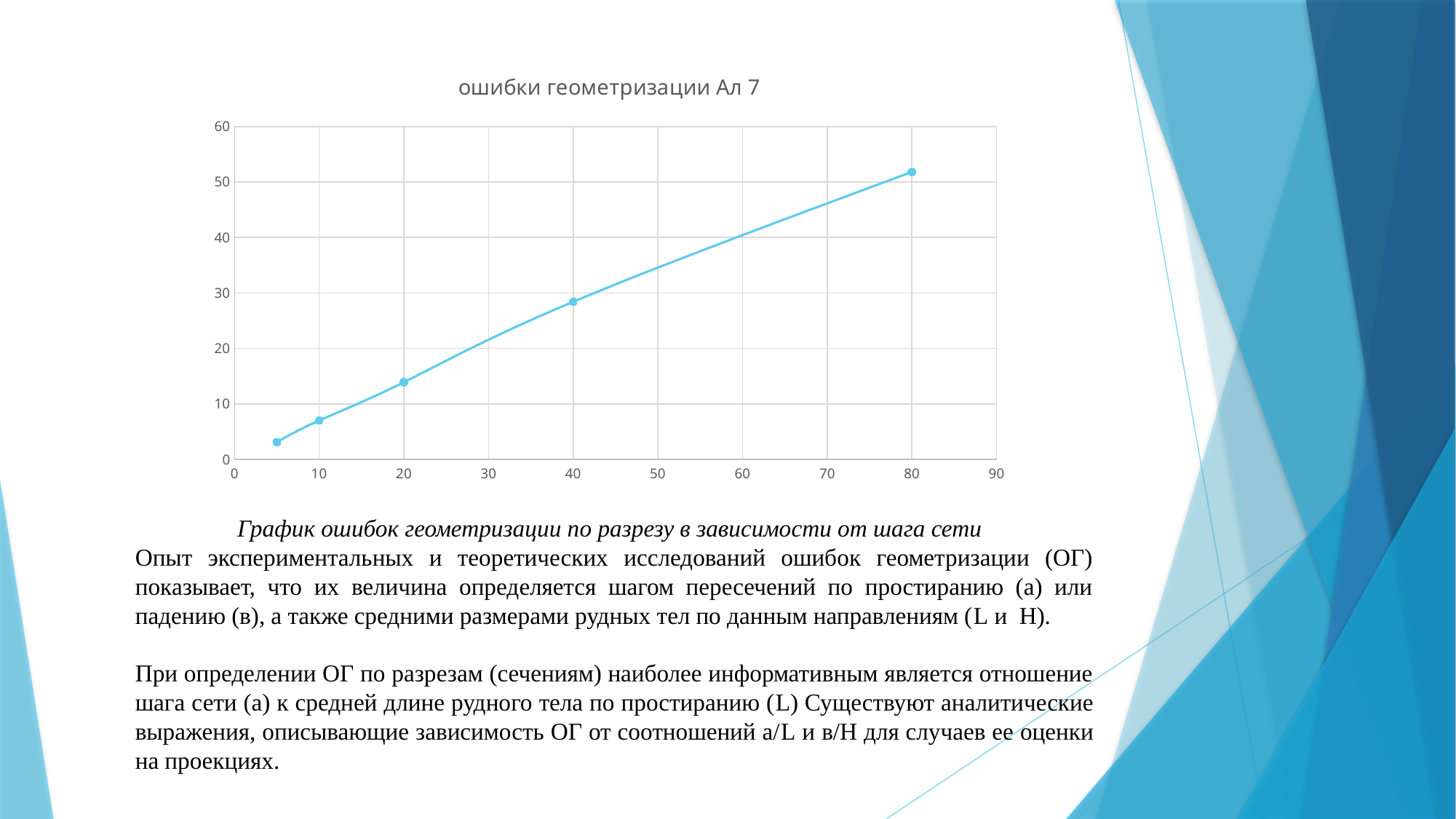
Do the values rise or fall as the x value increases from 5 to 80? rise Which is larger, the value at x = 40 or the value at x = 10? x = 40 Is the value at x = 80 greater or less than 50? greater At which x value is the plotted value highest? 80 Is the value at x = 5 greater or less than 10? less Is the value at x = 20 greater or less than 10? greater What kind of chart is shown on the slide? line chart What is the maximum value shown on the vertical axis? 60 What is the title of the chart? ошибки геометризации Ал 7 At which x value is the plotted value lowest? 5 How many data points are plotted on the chart? 5